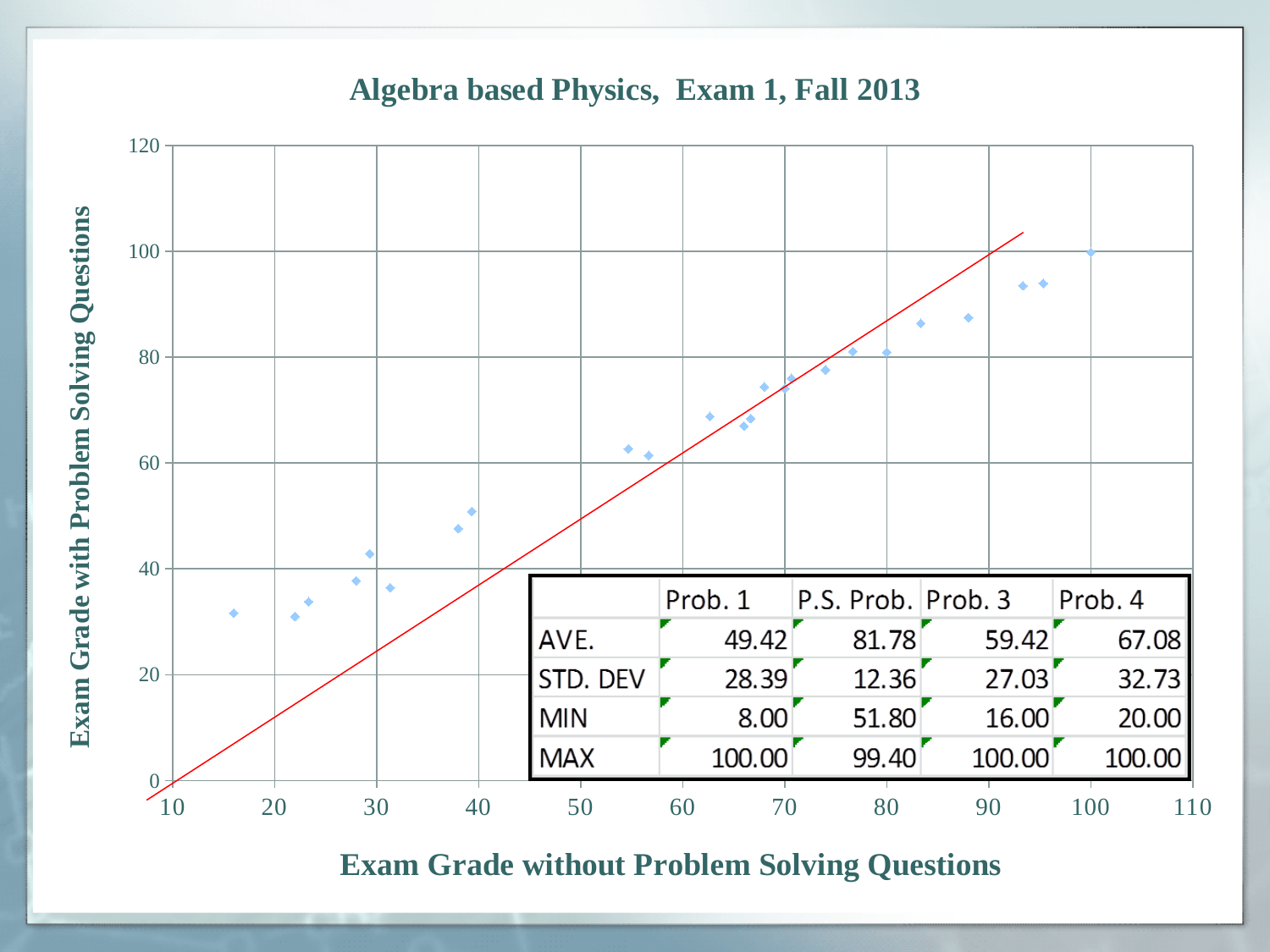
What is the label of the horizontal axis? Exam Grade without Problem Solving Questions In the table on the chart, what is the average (AVE.) for P.S. Prob.? 81.78 What is the title of the chart? Algebra based Physics, Exam 1, Fall 2013 In the table on the chart, what is the MIN value for Prob. 1? 8.00 Is the value on the vertical axis for the leftmost point (around 16 on the horizontal axis) greater or less than 40? less In the table on the chart, which problem has the lowest average (AVE.)? Prob. 1 In the table on the chart, what is the difference between the MAX values of Prob. 1 and P.S. Prob.? 0.60 Is the value on the vertical axis for the point at the far right of the chart (around 100 on the horizontal axis) greater or less than 80? greater Do the plotted points generally rise or fall as the exam grade without problem solving questions increases? rise What kind of chart is shown on the slide? scatter chart In the table on the chart, which problem has the highest standard deviation (STD. DEV)? Prob. 4 What is the maximum value shown on the vertical axis? 120